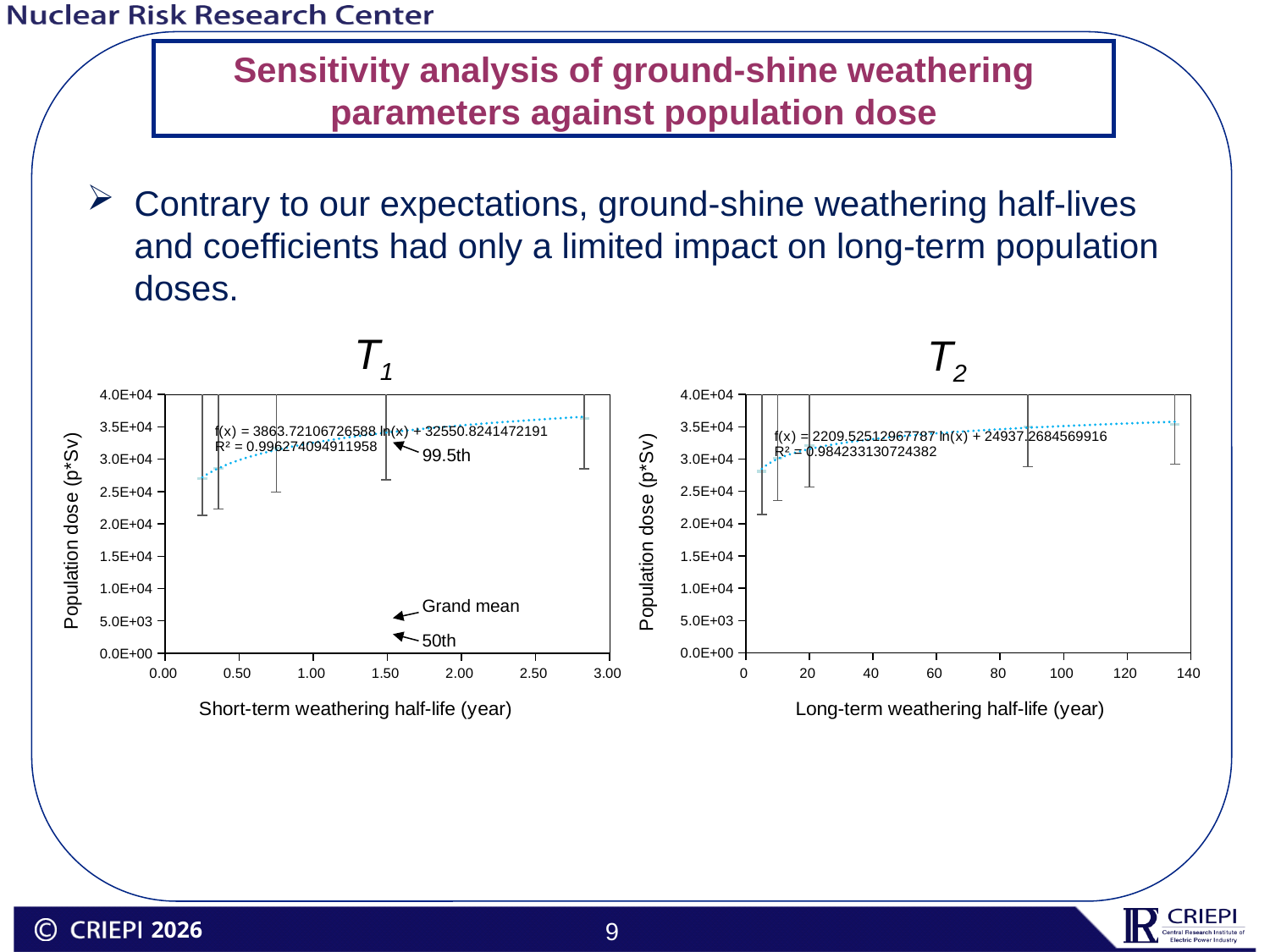
In the T2 chart, does the population dose rise or fall as the long-term weathering half-life increases? rise What kind of chart is the T1 chart on the left? scatter chart In the T1 chart, does the population dose rise or fall as the short-term weathering half-life increases? rise In the T2 chart, is the population dose for the rightmost point (near 135 years) greater or less than 3.0E+04? greater What is the x-axis title of the T2 chart? Long-term weathering half-life (year) In the T1 chart, is the population dose for the rightmost point (near 2.85 years) greater or less than 3.0E+04? greater In the T1 chart, which point has the higher population dose, the leftmost or the rightmost? rightmost How many data points are plotted in the T1 chart? 5 In the T1 chart, is the population dose for the leftmost point (near 0.25 years) greater or less than 2.5E+04? greater How many data points are plotted in the T2 chart? 5 What R² value is shown for the trendline in the T2 chart? 0.984233130724382